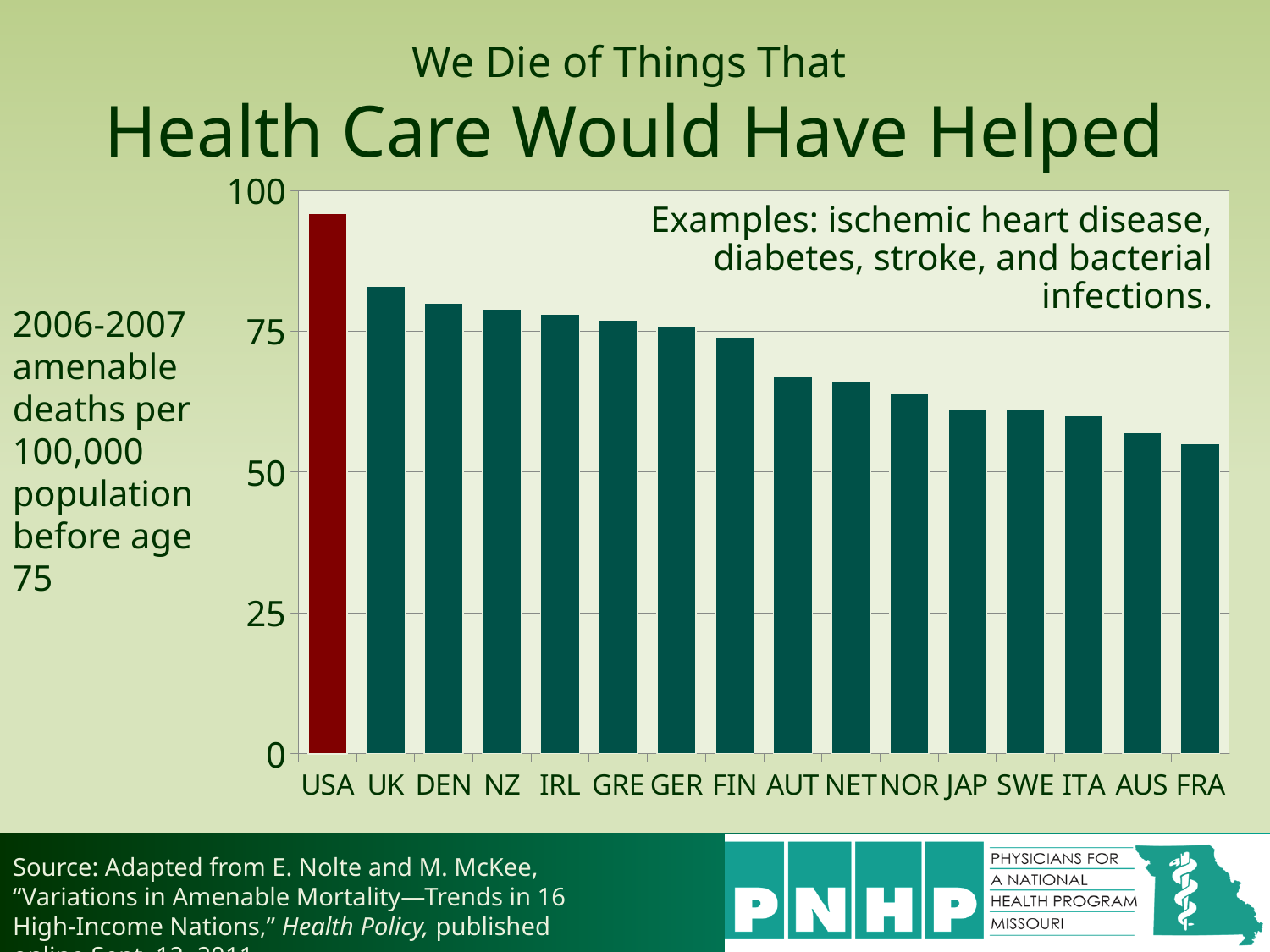
What kind of chart is shown on the slide? Bar chart Which country's bar is shown in a different colour (dark red) from the others? USA Is the value for UK greater or less than 75? greater Which has a higher value, GER or NOR? GER Is the value for AUT greater or less than 75? less Is the value for USA greater or less than 75? greater Which has a higher value, USA or UK? USA Which country has the lowest number of amenable deaths per 100,000 population in the chart? FRA How many countries are shown on the x axis of the chart? 16 Do the bar values rise or fall moving from left to right along the x axis? Fall Which country has the highest number of amenable deaths per 100,000 population in the chart? USA